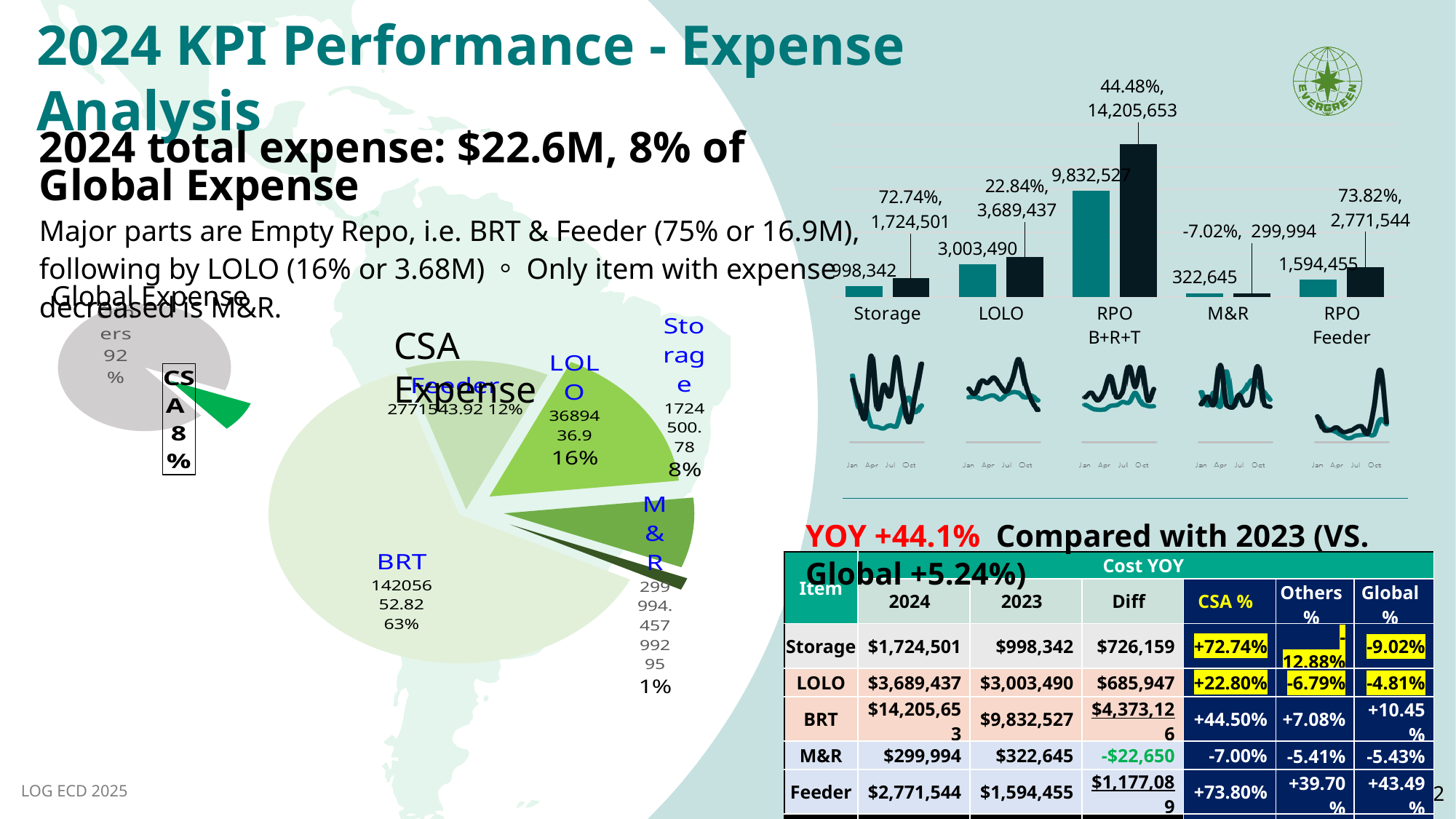
In the bar chart at the top right, how many categories are shown on the x axis? 5 In the CSA Expense pie chart, which slice is the smallest? M&R In the bar chart at the top right, which category has the tallest bar? RPO B+R+T In the bar chart at the top right, what is the difference between the two labelled values for RPO Feeder (2,771,544 and 1,594,455)? 1,177,089 In the CSA Expense pie chart, what share does BRT have? 63% In the bar chart at the top right, what percentage change is shown above the Storage category? 72.74% In the bar chart at the top right, what value is labelled on the taller (dark) bar for RPO B+R+T? 14,205,653 What kind of chart is the CSA Expense chart? pie chart In the Global Expense pie chart, what share does CSA have? 8% In the bar chart at the top right, which category shows a negative percentage change? M&R In the bar chart at the top right, is the dark bar for M&R (299,994) larger or smaller than the teal bar for M&R (322,645)? smaller In the bar chart at the top right, what value is labelled on the shorter (teal) bar for LOLO? 3,003,490